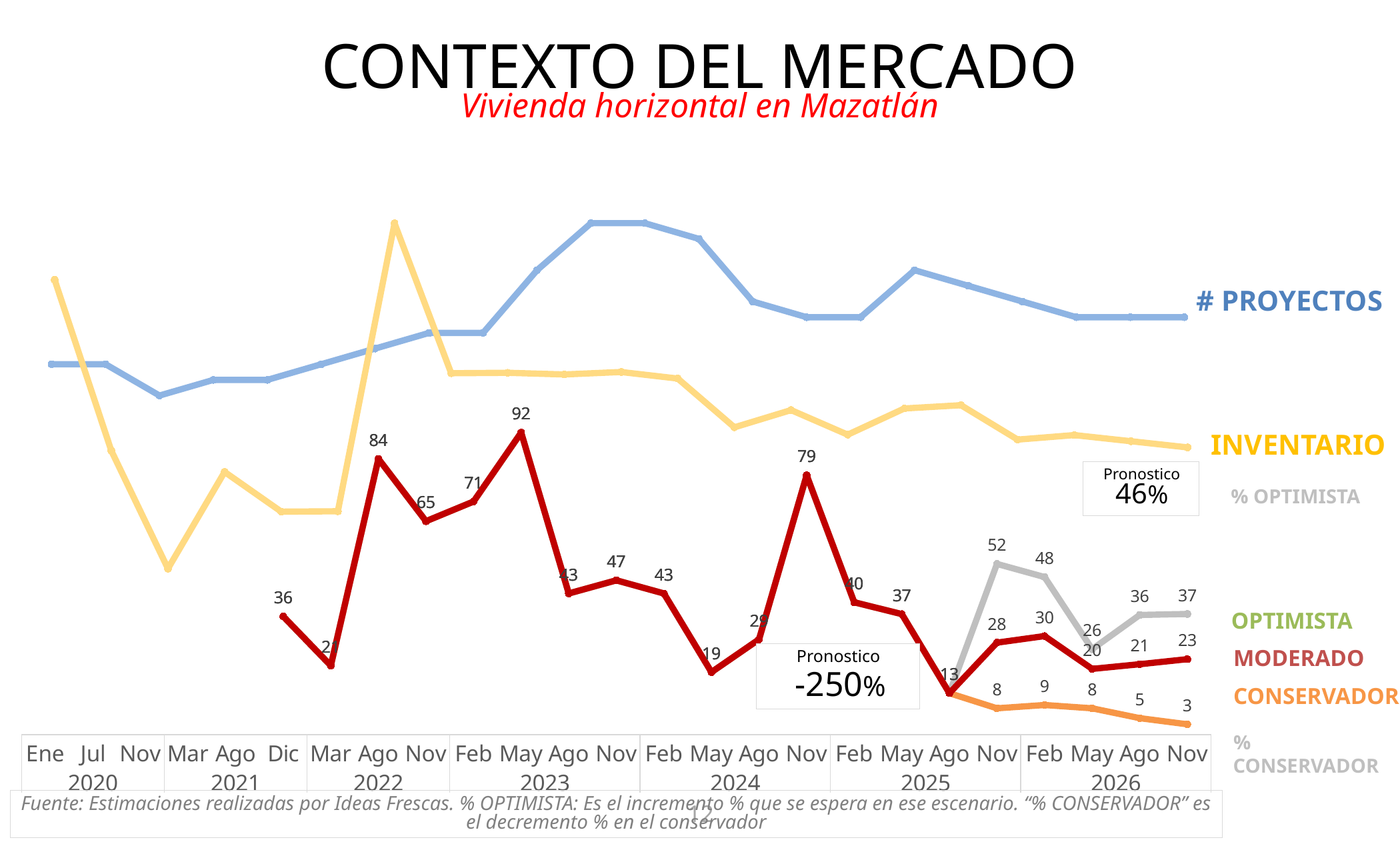
What is the title of the slide's chart? CONTEXTO DEL MERCADO What is the value of the MODERADO line at Nov 2024? 79 What is the value of the CONSERVADOR line at Nov 2026? 3 What is the lowest labeled value on the MODERADO line? 13 What is the difference between the MODERADO values at May 2023 (92) and Ago 2022 (84)? 8 What is the highest labeled value on the MODERADO line? 92 Does the CONSERVADOR line rise or fall from Nov 2025 to Nov 2026? fall What Pronostico value is shown in the box next to the % OPTIMISTA label? 46% What is the value of the OPTIMISTA line at Nov 2025? 52 At Nov 2026, which is larger: the OPTIMISTA value or the MODERADO value? OPTIMISTA What kind of chart is shown on the slide? line chart What is the lowest labeled value on the OPTIMISTA line? 26